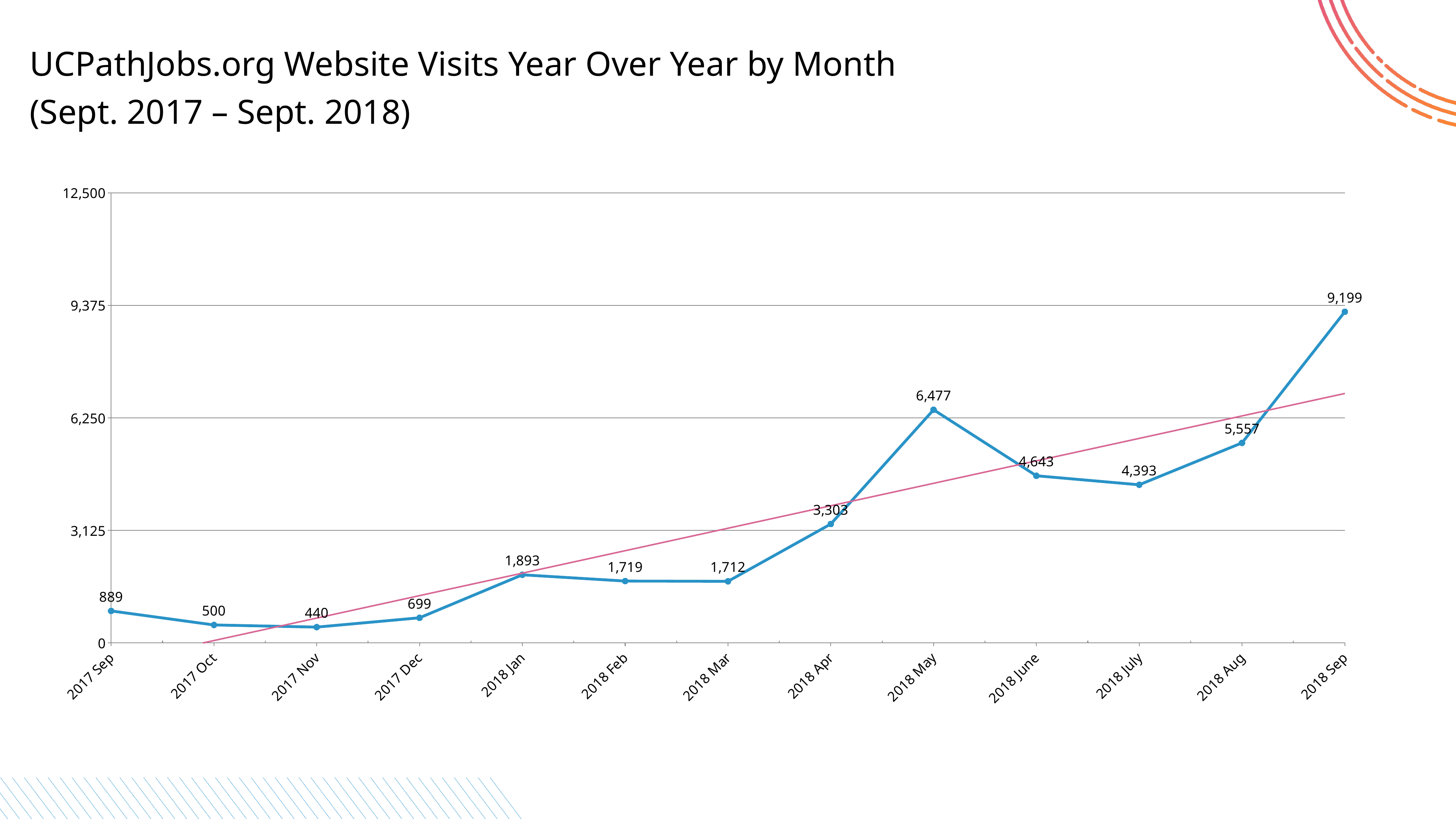
Which month has the highest number of website visits? 2018 Sep What is the value for 2018 Aug? 5,557 What is the value for 2017 Nov? 440 Overall, do website visits rise or fall from 2017 Sep to 2018 Sep? rise What kind of chart is shown on the slide? line chart What is the difference in visits between 2018 Sep and 2018 Aug? 3,642 How many website visits were recorded in 2018 May? 6,477 Which month has the lowest number of website visits? 2017 Nov Is the value for 2018 Apr greater or less than 3,125? greater What is the difference in visits between 2018 May and 2018 June? 1,834 Which month had more visits, 2018 June or 2018 July? 2018 June How many months are plotted on the x axis? 13